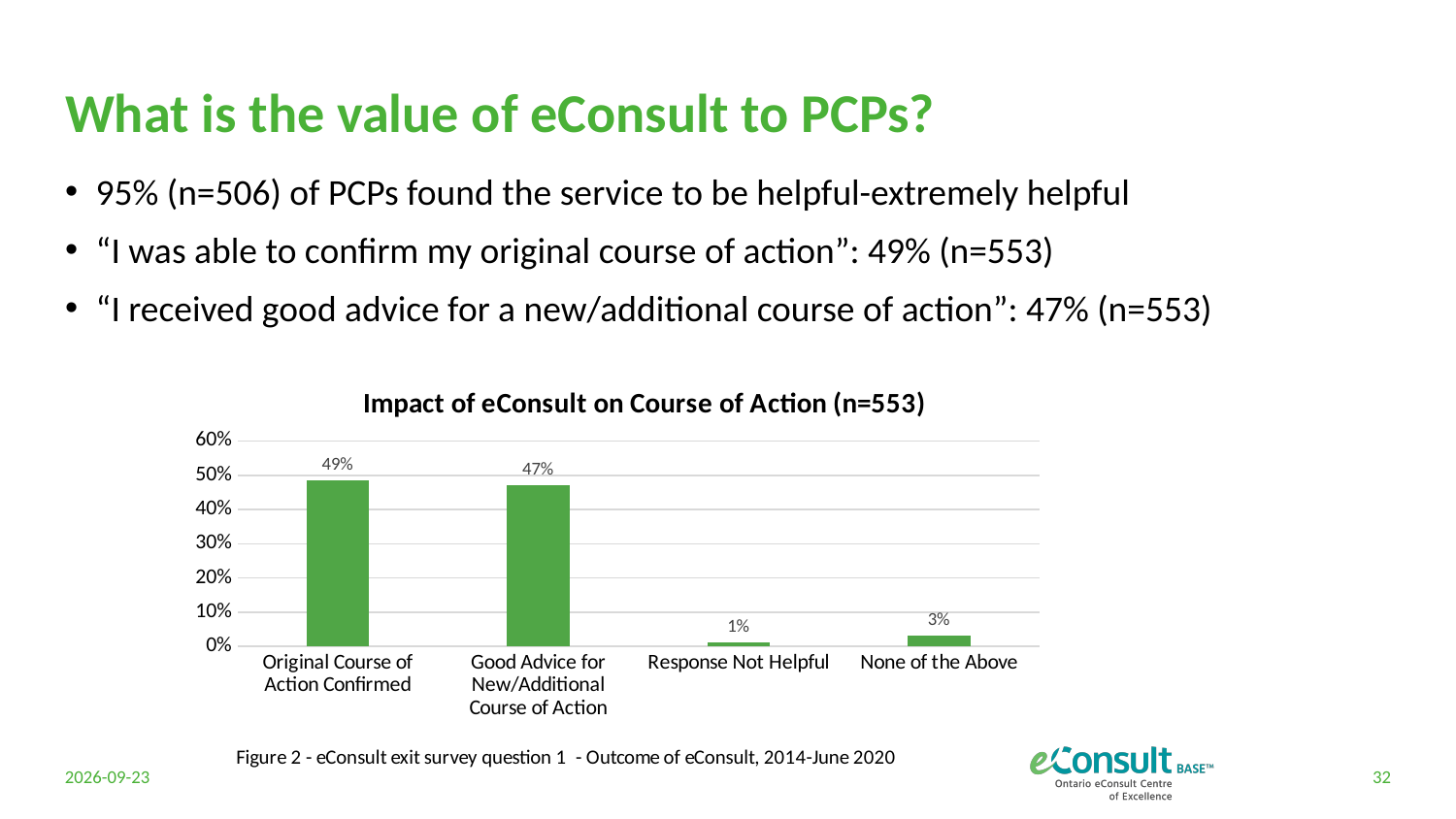
What is the value for Response Not Helpful? 1% How many categories are shown on the x axis? 4 What kind of chart is shown? bar chart What is the title of the chart? Impact of eConsult on Course of Action (n=553) What is the value for Original Course of Action Confirmed? 49% What is the value for Good Advice for New/Additional Course of Action? 47% Which is larger: None of the Above or Response Not Helpful? None of the Above What is the difference between Original Course of Action Confirmed and Good Advice for New/Additional Course of Action? 2% Which category has the lowest value? Response Not Helpful Is the value for Good Advice for New/Additional Course of Action greater or less than 40%? greater What is the value for None of the Above? 3% Which category has the highest value? Original Course of Action Confirmed